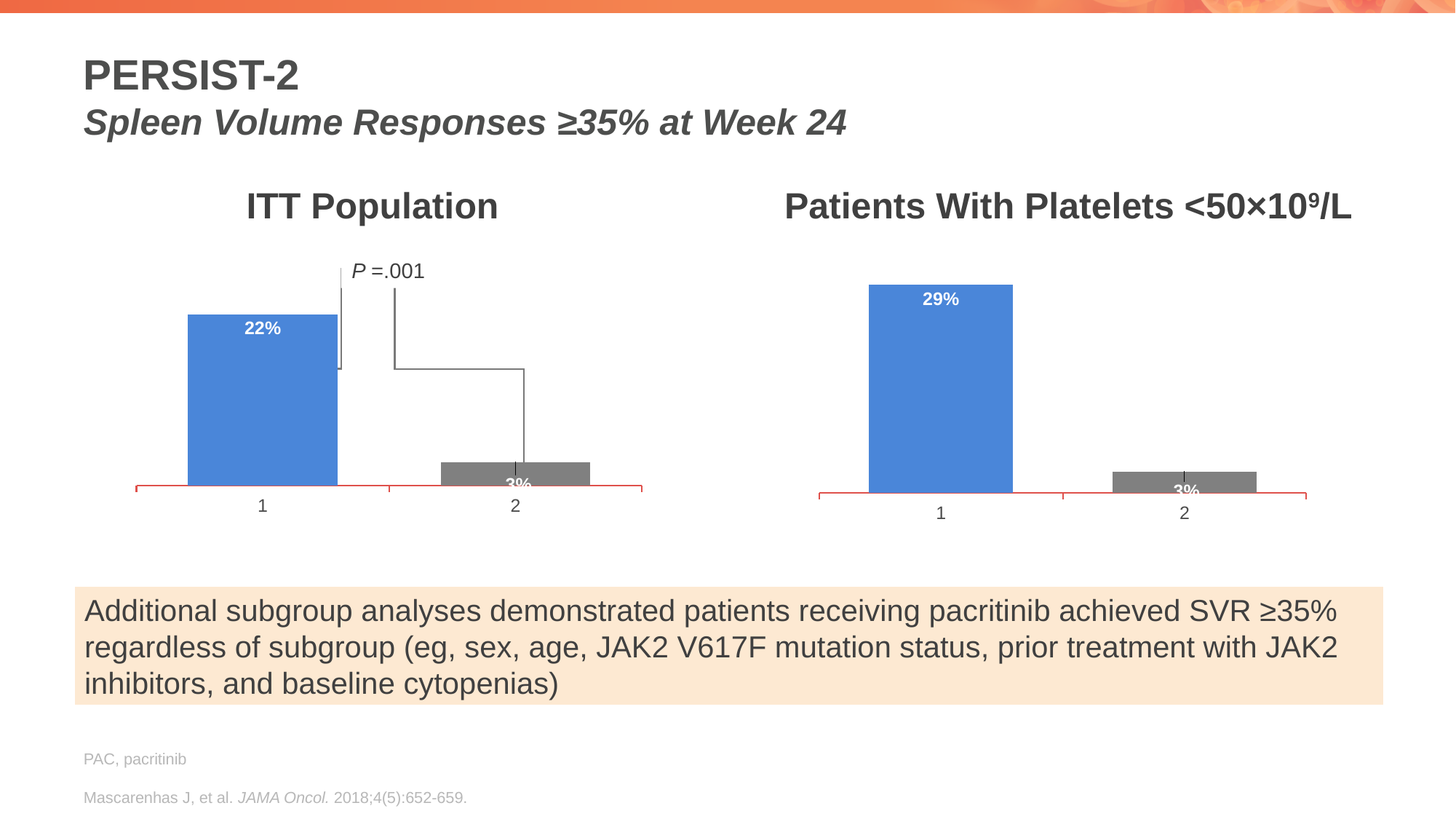
What P value is shown on the ITT Population chart? P =.001 How many categories are shown in the ITT Population chart? 2 In the Patients With Platelets <50×10⁹/L chart, what is the value for category 1? 29% What type of chart is the Patients With Platelets <50×10⁹/L chart? Bar chart In the ITT Population chart, what is the value for category 2? 3% In the ITT Population chart, which category has the highest value? 1 In the ITT Population chart, what is the value for category 1? 22% Which is larger: the value for category 1 in the ITT Population chart or the value for category 1 in the Patients With Platelets <50×10⁹/L chart? Patients With Platelets <50×10⁹/L In the Patients With Platelets <50×10⁹/L chart, what is the difference between the values for category 1 and category 2? 26% In the ITT Population chart, what is the difference between the values for category 1 and category 2? 19% In the Patients With Platelets <50×10⁹/L chart, which category has the lowest value? 2 In the ITT Population chart, what colour is the bar for category 1? Blue